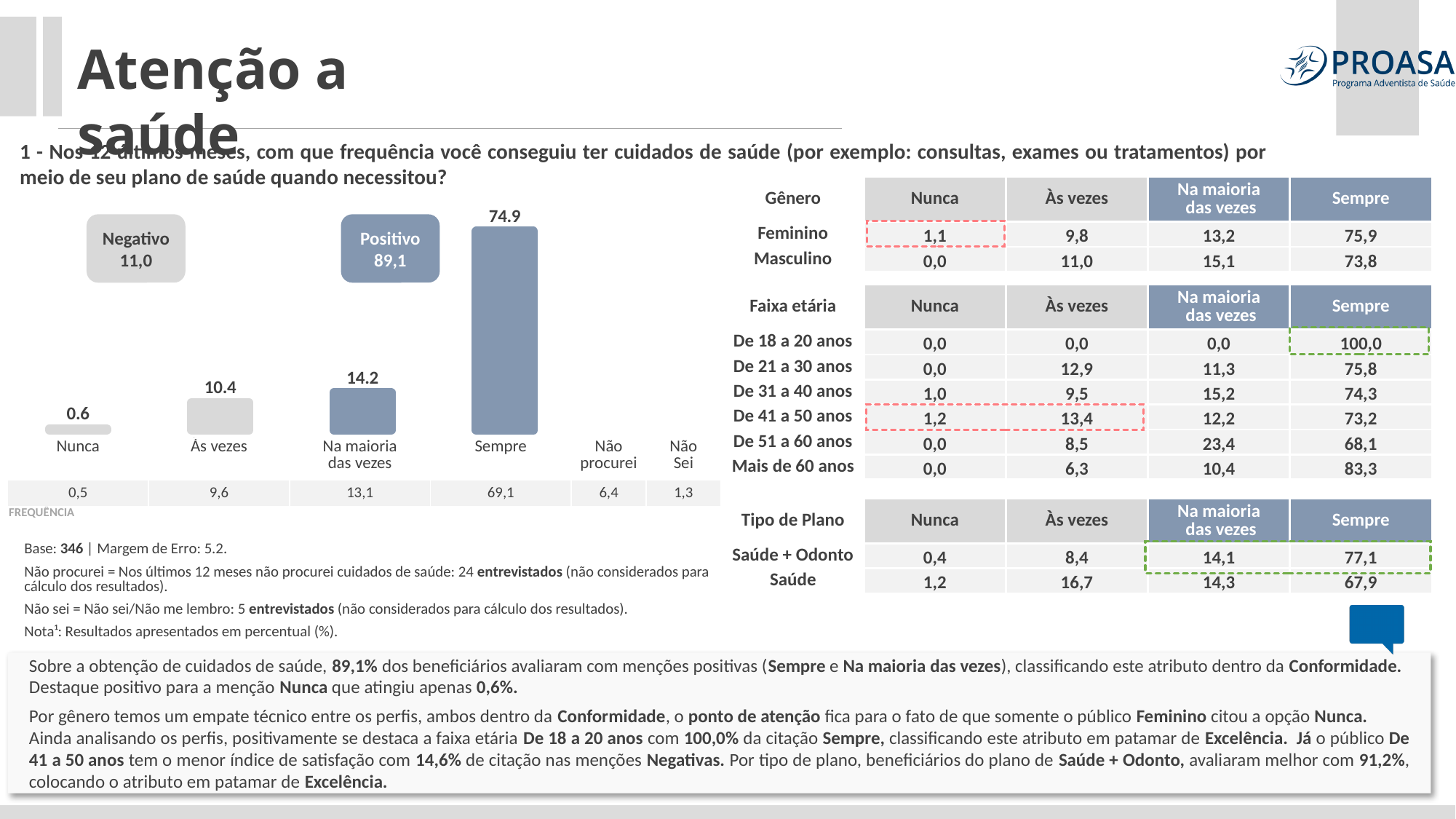
What kind of chart is shown on the slide? Bar chart What value is shown in the Positivo box above the chart? 89,1 Which is larger, the bar for Às vezes or the bar for Na maioria das vezes? Na maioria das vezes What is the value of the bar for Na maioria das vezes? 14.2 What is the value of the bar for Sempre? 74.9 What is the difference between the values for Às vezes and Nunca? 9.8 What is the value of the bar for Às vezes? 10.4 Which category has the lowest bar in the chart? Nunca What is the value of the bar for Nunca? 0.6 Which category has the highest bar in the chart? Sempre Do the bar values rise or fall from Nunca to Sempre along the x axis? Rise What is the difference between the values for Sempre and Na maioria das vezes? 60.7